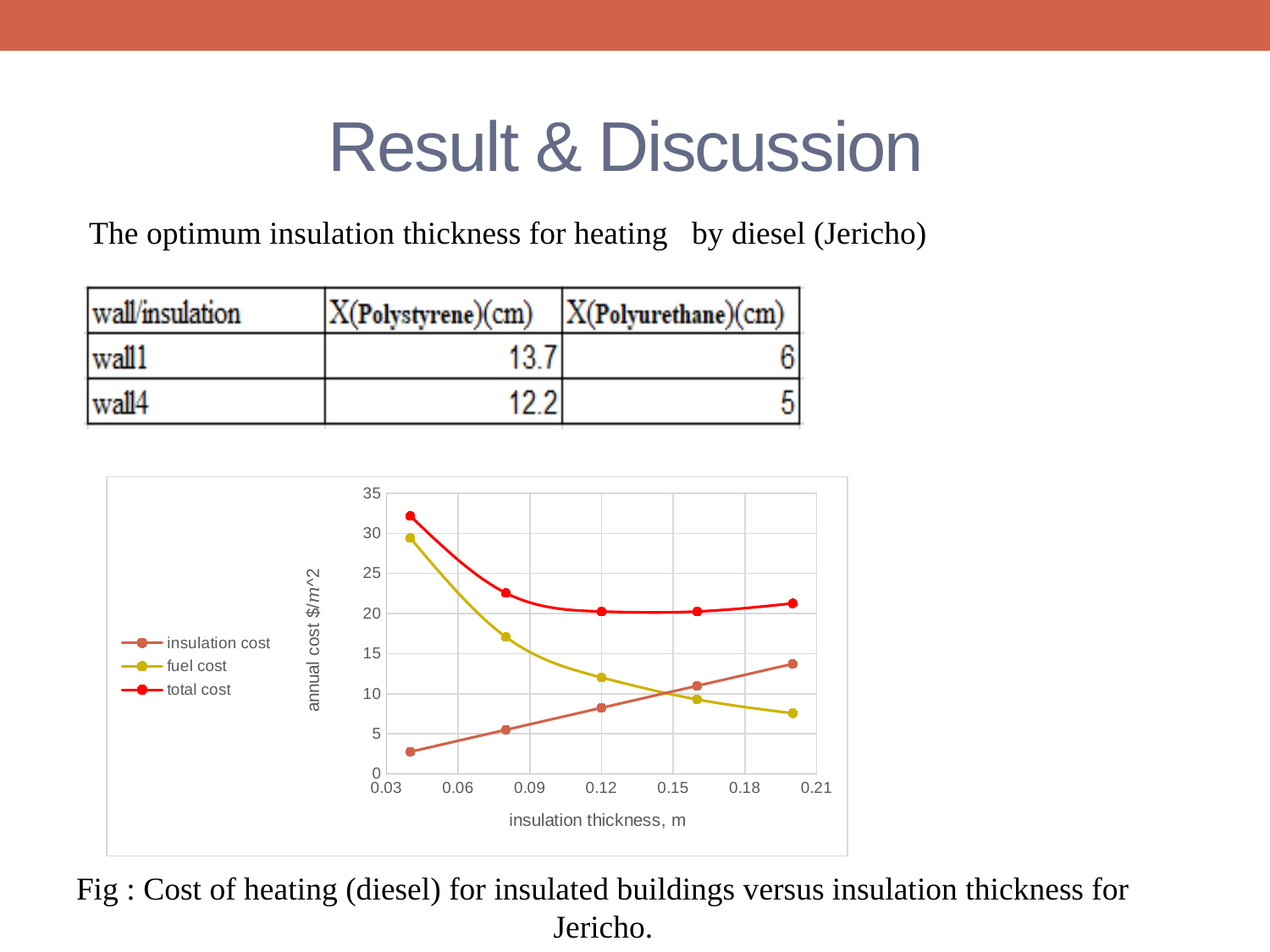
Is the total cost at the smallest plotted insulation thickness greater or less than 30? greater At the smallest plotted insulation thickness, which series has the lowest value? insulation cost What is the label of the chart's y axis? annual cost $/m^2 Is the fuel cost at the largest plotted insulation thickness greater or less than 10? less What is the label of the chart's x axis? insulation thickness, m Does the insulation cost rise or fall as insulation thickness increases? rises How many data points are plotted for the total cost series? 5 What kind of chart is shown on the slide? line chart How many series does the chart's legend list? 3 Does the fuel cost rise or fall as insulation thickness increases? falls At the largest plotted insulation thickness, which is higher: insulation cost or fuel cost? insulation cost Is the insulation cost at the smallest plotted insulation thickness greater or less than 5? less